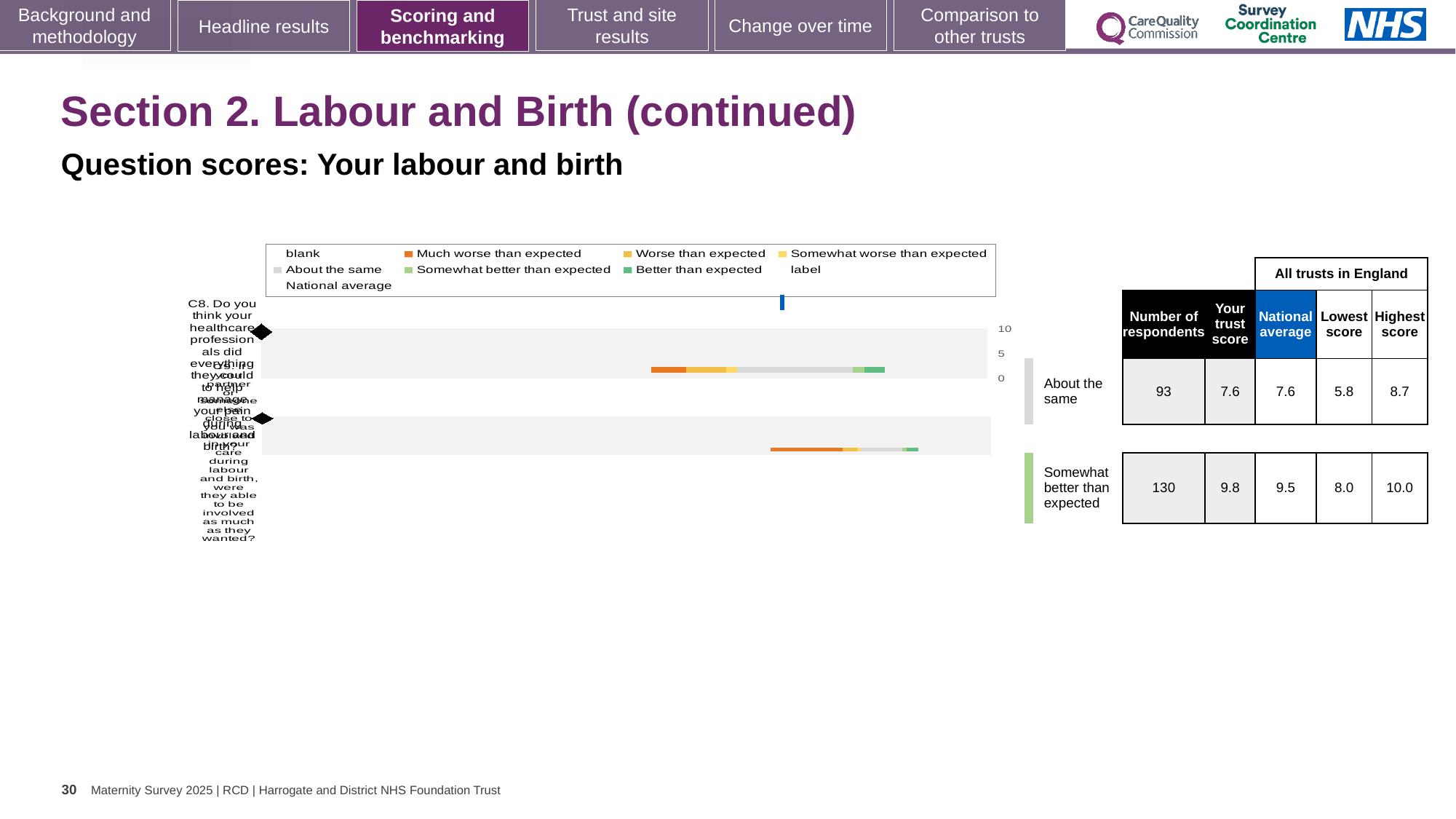
What is the national average for the row labelled 'About the same'? 7.6 How many question bars are plotted in the chart? 2 What kind of chart is shown on the slide? bar chart Which row has the larger number of respondents, 'About the same' or 'Somewhat better than expected'? Somewhat better than expected What is the difference between the trust score and the national average for the row labelled 'Somewhat better than expected'? 0.3 In the table beside the chart, what is the number of respondents for the row labelled 'Somewhat better than expected'? 130 What is the heading above the 'National average', 'Lowest score' and 'Highest score' columns in the table? All trusts in England In the table beside the chart, what is the number of respondents for the row labelled 'About the same'? 93 Which row has the higher 'Your trust score'? Somewhat better than expected What is the highest score across all trusts in England for the row labelled 'Somewhat better than expected'? 10.0 What is the 'Your trust score' for the row labelled 'Somewhat better than expected'? 9.8 What is the lowest score across all trusts in England for the row labelled 'About the same'? 5.8